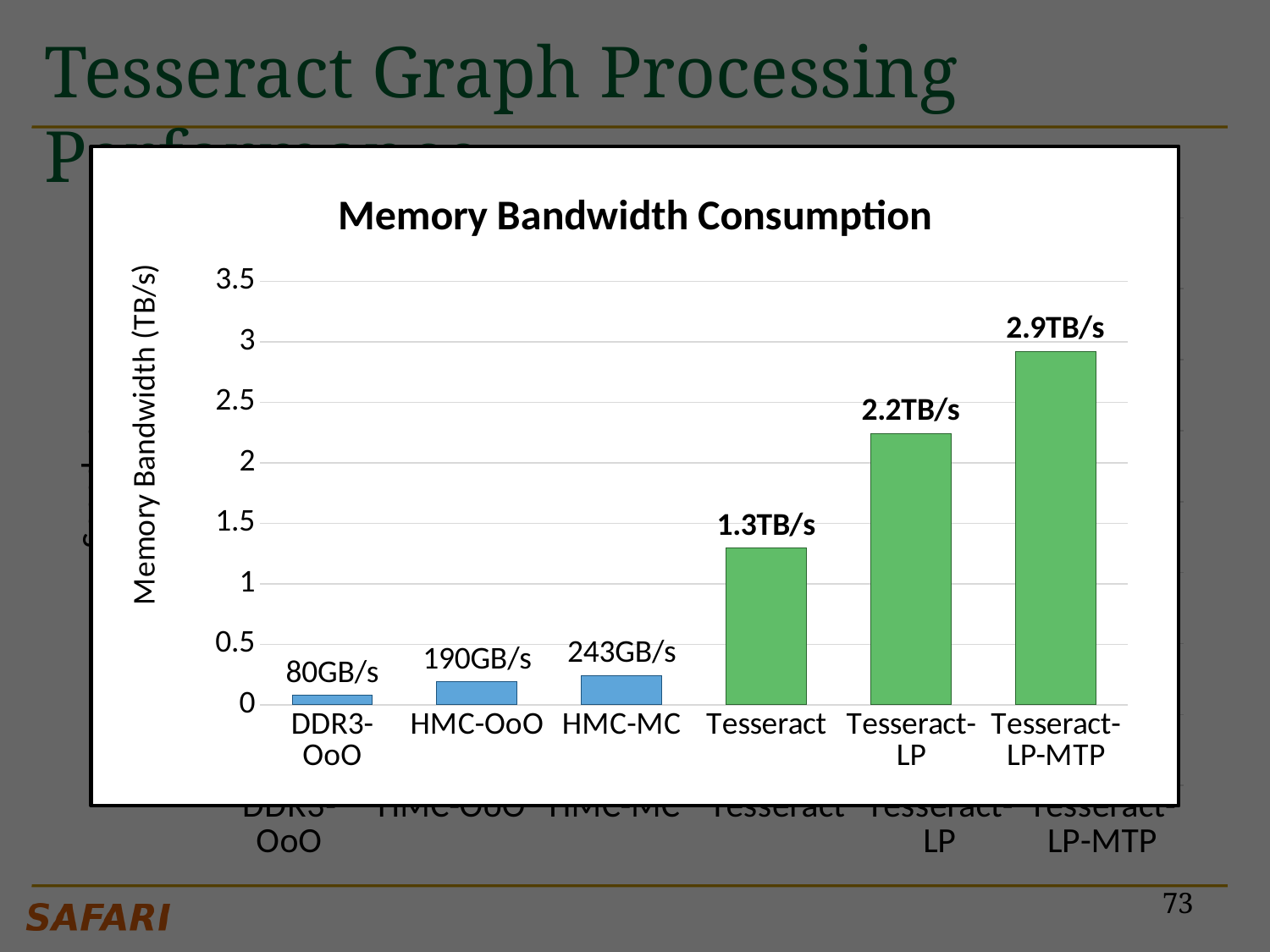
What kind of chart is shown on the slide? Bar chart What is the memory bandwidth consumption for Tesseract-LP-MTP? 2.9TB/s How many configurations are shown on the x axis of the chart? 6 Is the value for Tesseract-LP greater or less than 2 TB/s? greater Which configuration has the lowest memory bandwidth consumption? DDR3-OoO Which has higher memory bandwidth consumption, HMC-OoO or Tesseract? Tesseract Which configuration has the highest memory bandwidth consumption? Tesseract-LP-MTP What is the difference in memory bandwidth between HMC-MC and HMC-OoO? 53GB/s Do the memory bandwidth values rise or fall from left to right along the x axis? Rise What is the memory bandwidth consumption for HMC-MC? 243GB/s What is the difference in memory bandwidth between Tesseract-LP-MTP and Tesseract-LP? 0.7TB/s What is the memory bandwidth consumption for DDR3-OoO? 80GB/s